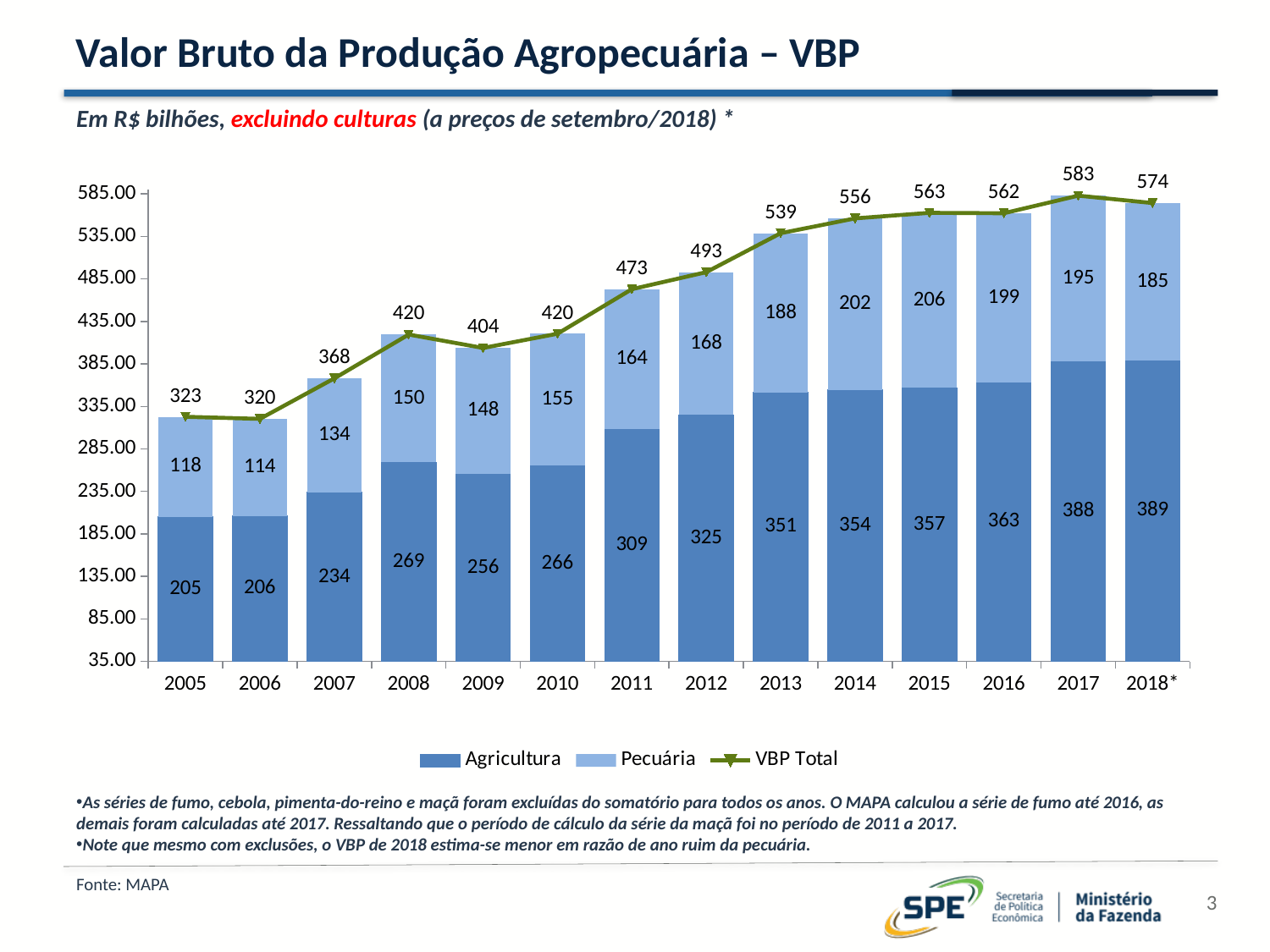
What is the difference between the Agricultura values for 2018* and 2005? 184 Which year has the lowest Pecuária value? 2006 Which year has the highest VBP Total? 2017 Does the VBP Total generally rise or fall from 2005 to 2017? Rise What is the total of the stacked bar for 2012 (Agricultura plus Pecuária)? 493 What kind of chart is shown on the slide? Stacked bar chart with a line What is the VBP Total value for 2017? 583 What is the Agricultura value for 2013? 351 How many series does the legend list? 3 Which is larger, the Pecuária value for 2015 or for 2016? 2015 How many years are shown on the x axis? 14 What is the Pecuária value for 2010? 155